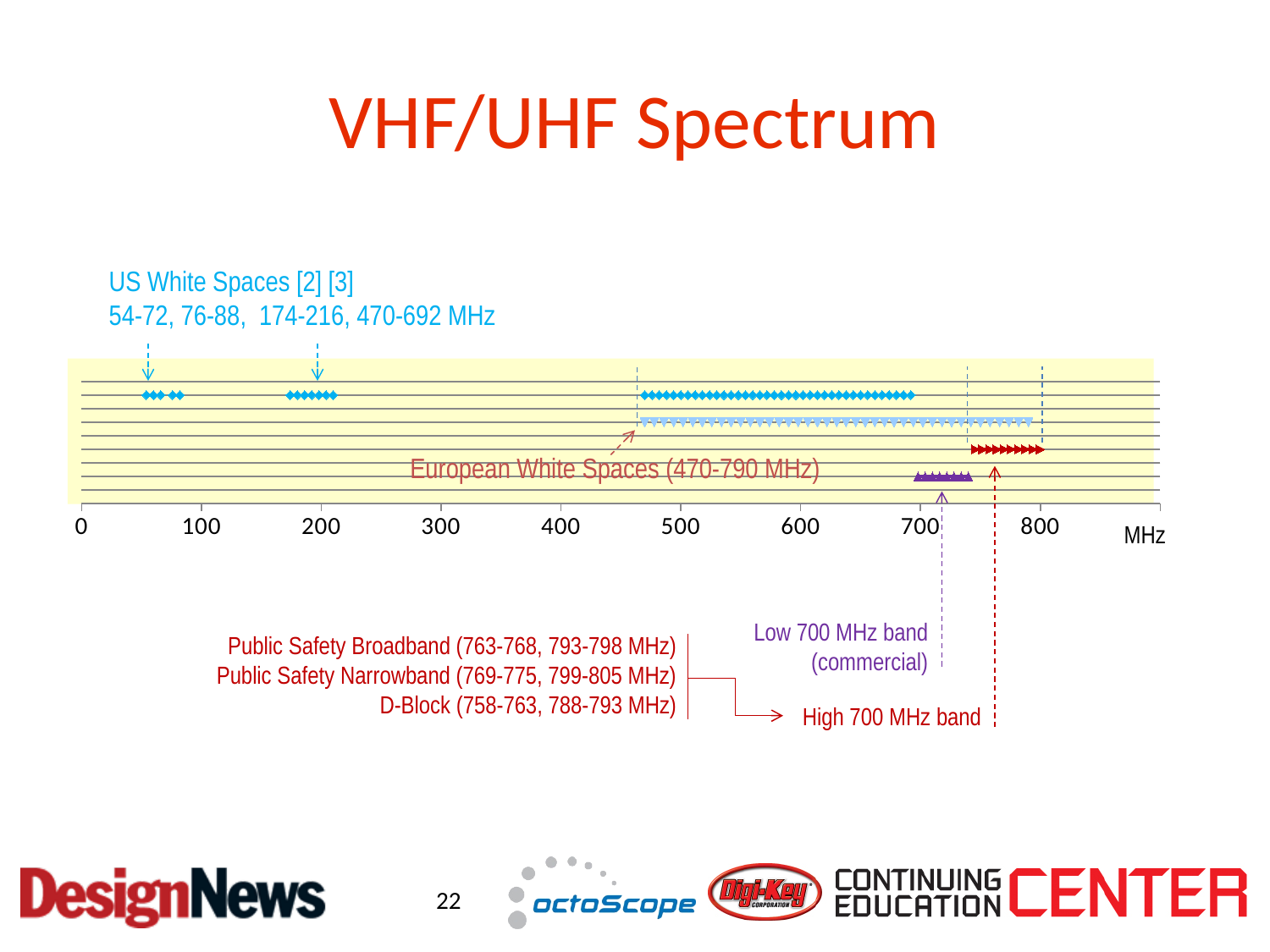
What unit is shown on the x axis of the spectrum chart? MHz What is the lowest frequency range listed for the US White Spaces? 54-72 MHz What is the largest tick label shown on the x axis? 800 Which extends to a higher frequency: the US White Spaces or the European White Spaces? European White Spaces Is the High 700 MHz band plotted at frequencies greater or less than 700 MHz? greater By how many MHz does the upper limit of the European White Spaces (790 MHz) exceed the upper limit of the US White Spaces (692 MHz)? 98 MHz What frequency range is given for the European White Spaces? 470-790 MHz What frequency ranges are listed for the D-Block? 758-763, 788-793 MHz What frequency ranges are listed for Public Safety Broadband? 763-768, 793-798 MHz What is the title of the chart on the slide? VHF/UHF Spectrum What is the highest frequency range listed for the US White Spaces? 470-692 MHz How many separate frequency ranges are listed for the US White Spaces? 4